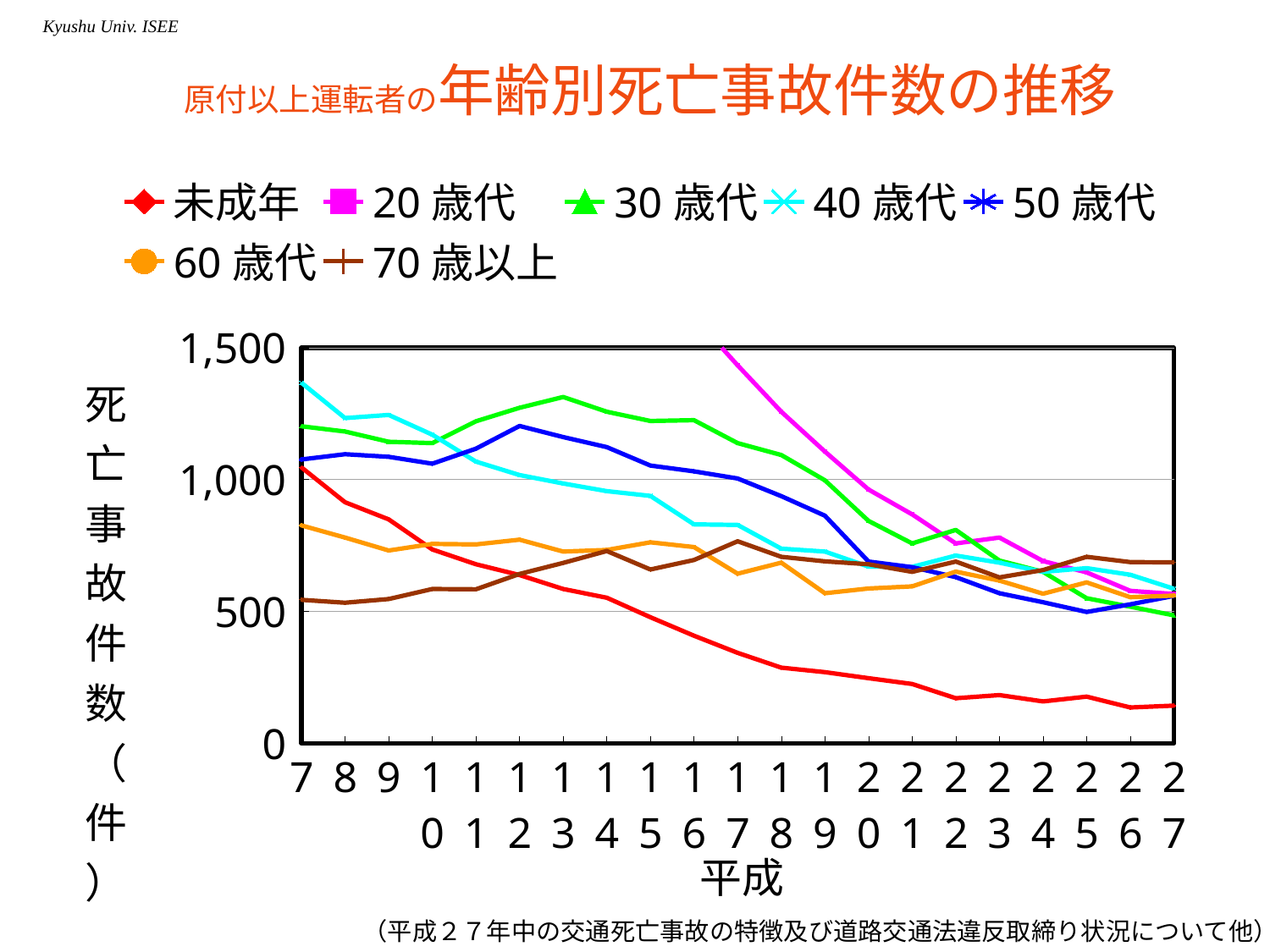
In 平成 27, which is larger: 未成年 or 70 歳以上? 70 歳以上 Is the value for 30 歳代 in 平成 13 greater or less than 1,000? greater Is the value for 未成年 in 平成 27 greater or less than 500? less Is the value for 70 歳以上 in 平成 7 greater or less than 1,000? less How many series does the legend list? 7 What is the label of the x axis? 平成 How many years (平成 7 to 27) are plotted along the x axis? 21 Does the 未成年 line rise or fall from 平成 7 to 平成 27? fall In 平成 7, which is larger: 40 歳代 or 70 歳以上? 40 歳代 Which series has the lowest value in 平成 27? 未成年 What kind of chart is shown on the slide? line chart